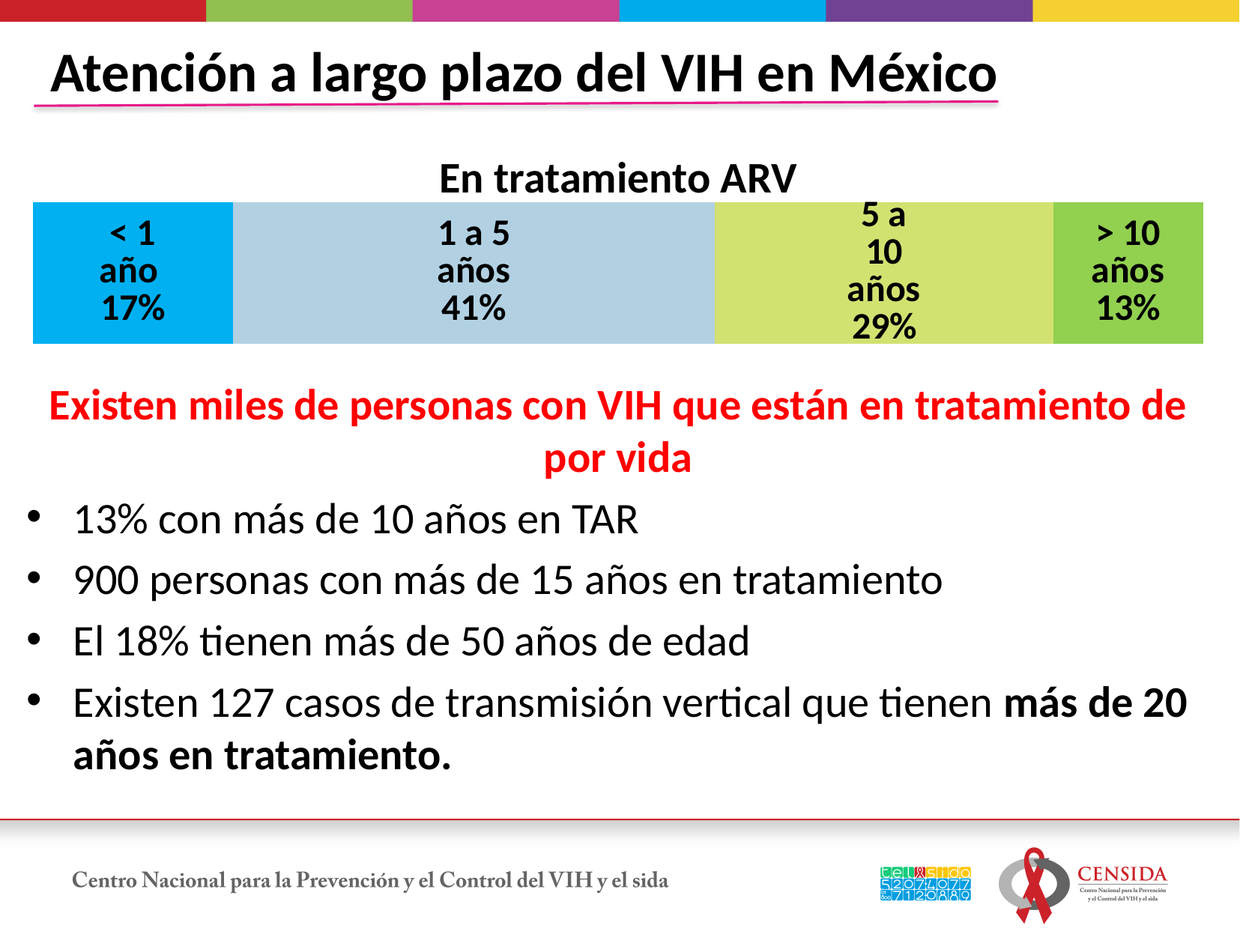
What is the title of the chart on the slide? En tratamiento ARV Which treatment-duration category has the largest share? 1 a 5 años What is the difference in percentage points between the "1 a 5 años" and "5 a 10 años" segments? 12 Which treatment-duration category has the smallest share? > 10 años What kind of chart is shown under "En tratamiento ARV"? Stacked bar chart What percentage is shown for the "5 a 10 años" segment? 29% What percentage is shown for the "> 10 años" segment? 13% What is the total of all four segments in the bar? 100% What percentage of people in ARV treatment have been in treatment for less than 1 year (< 1 año)? 17% How many treatment-duration categories are shown in the bar? 4 What percentage is shown for the "1 a 5 años" segment? 41% Which is larger, the share for "< 1 año" or the share for "> 10 años"? < 1 año